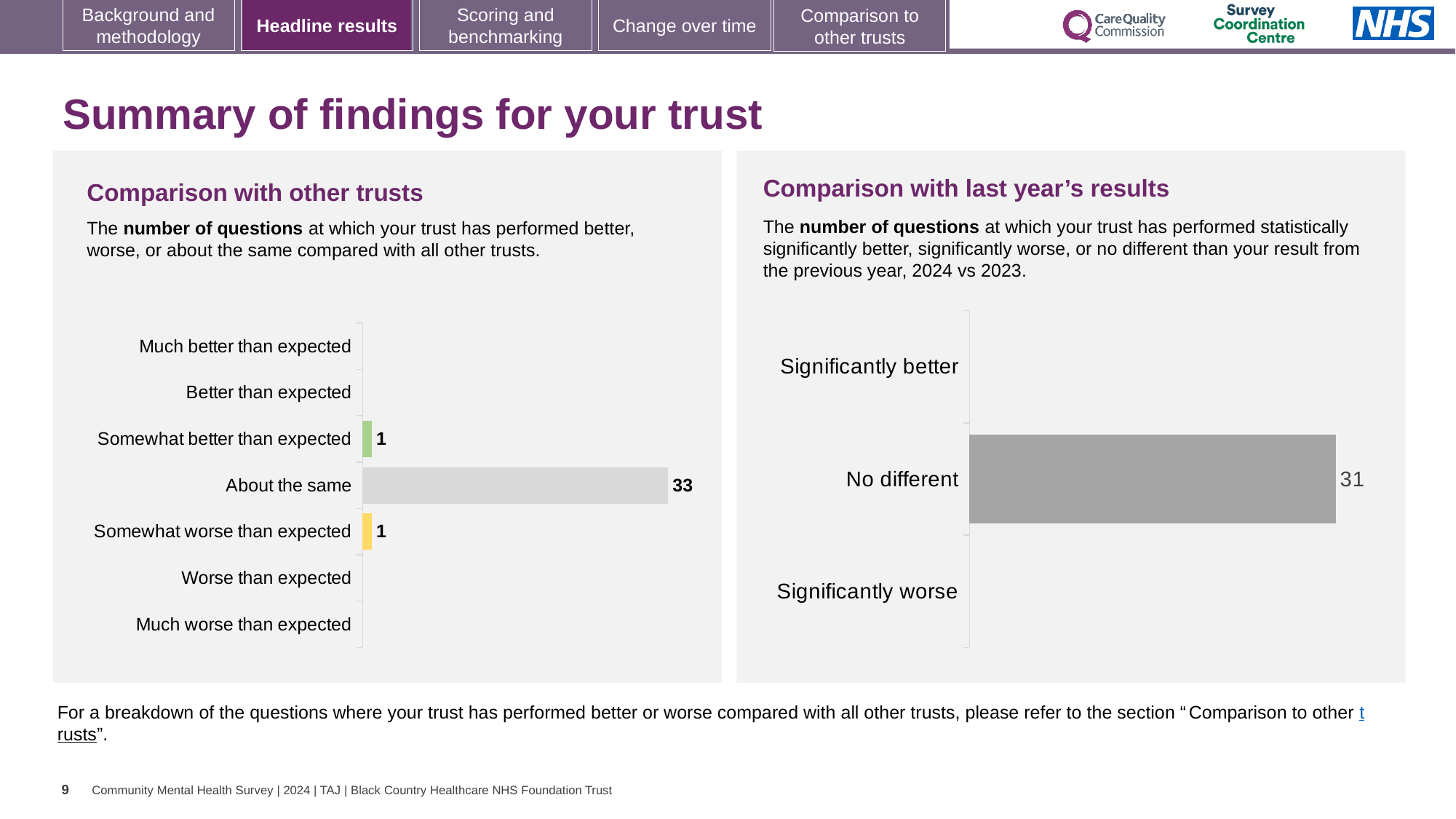
In the 'Comparison with other trusts' chart, how many categories are listed on the axis? 7 In the 'Comparison with last year's results' chart, how many categories are listed on the axis? 3 In the 'Comparison with last year's results' chart, which category has the highest value? No different In the 'Comparison with other trusts' chart, what is the value for 'About the same'? 33 In the 'Comparison with other trusts' chart, what is the value for 'Somewhat better than expected'? 1 In the 'Comparison with last year's results' chart, what is the value for 'No different'? 31 Which is larger: 'About the same' in the 'Comparison with other trusts' chart or 'No different' in the 'Comparison with last year's results' chart? About the same In the 'Comparison with other trusts' chart, which category has the highest value? About the same In the 'Comparison with other trusts' chart, what colour is the bar for 'Somewhat worse than expected'? Yellow In the 'Comparison with other trusts' chart, what kind of chart is shown? Bar chart In the 'Comparison with other trusts' chart, what is the difference between 'About the same' and 'Somewhat better than expected'? 32 In the 'Comparison with other trusts' chart, what is the value for 'Somewhat worse than expected'? 1